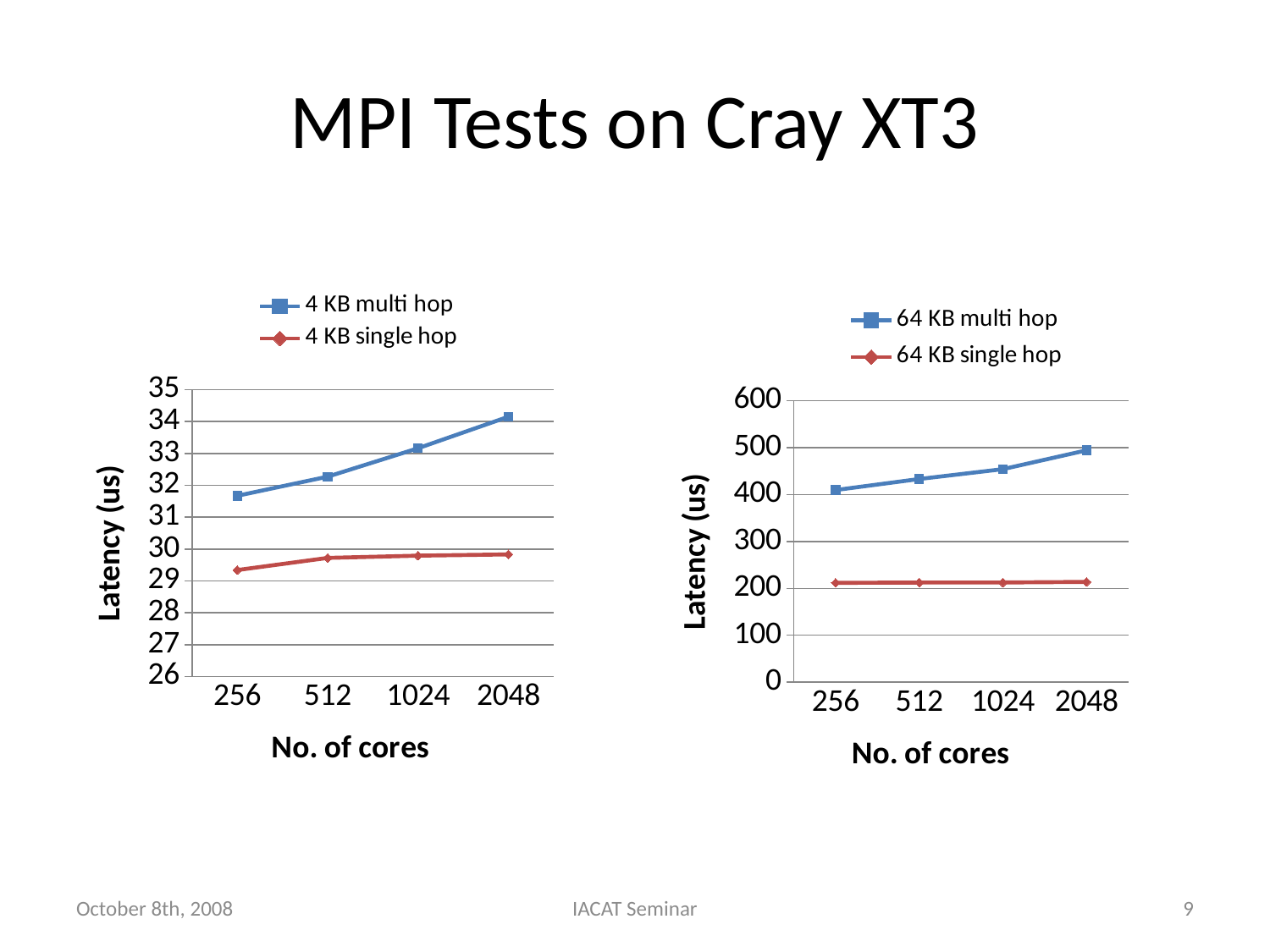
On the left chart (4 KB), what kind of chart is shown? line chart On the left chart (4 KB), is the latency for 4 KB single hop at 256 cores greater or less than 30? less On the right chart (64 KB), how many series does the legend list? 2 On the right chart (64 KB), what is the label of the x axis? No. of cores On the right chart (64 KB), does the latency for 64 KB multi hop rise or fall as the number of cores increases? rise On the right chart (64 KB), is the latency for 64 KB single hop at 1024 cores greater or less than 300? less On the left chart (4 KB), how many core counts are plotted along the x axis? 4 On the left chart (4 KB), at 1024 cores, which series has the higher latency, 4 KB multi hop or 4 KB single hop? 4 KB multi hop On the left chart (4 KB), how many series does the legend list? 2 On the right chart (64 KB), is the latency for 64 KB multi hop at 2048 cores greater or less than 400? greater On the left chart (4 KB), does the latency for 4 KB multi hop rise or fall as the number of cores increases? rise